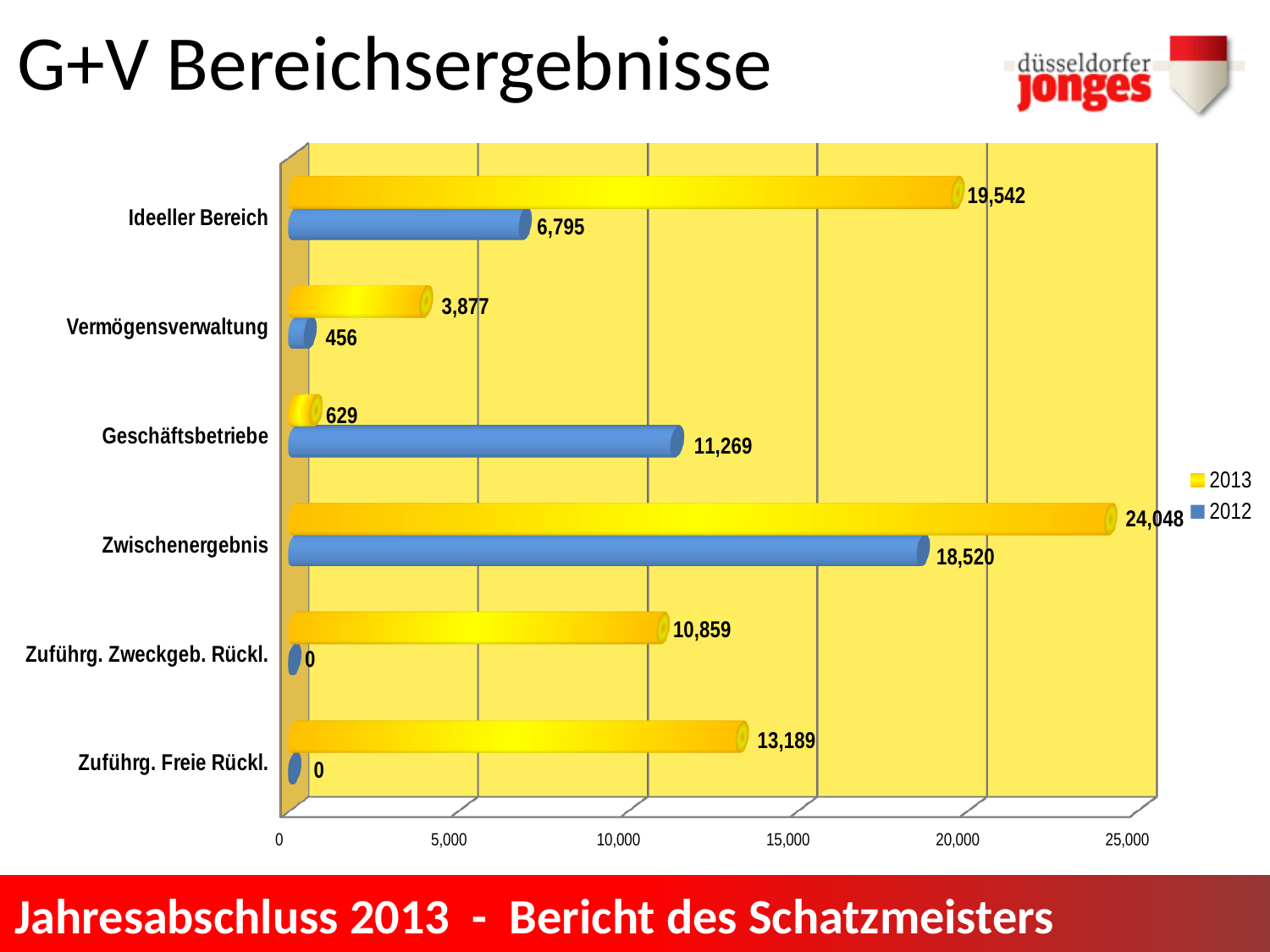
What is the difference between the 2013 and 2012 values for Zwischenergebnis? 5,528 Which is larger for Geschäftsbetriebe, the 2013 value or the 2012 value? 2012 What kind of chart is shown on the slide? Bar chart How many series does the legend list? 2 What is the 2012 value for Vermögensverwaltung? 456 What is the 2013 value for Ideeller Bereich? 19,542 Which category has the highest 2013 value? Zwischenergebnis How many categories are shown on the chart? 6 What is the 2012 value for Geschäftsbetriebe? 11,269 What is the 2013 value for Zuführg. Freie Rückl.? 13,189 What is the difference between the 2013 and 2012 values for Ideeller Bereich? 12,747 Which category has the lowest 2013 value? Geschäftsbetriebe